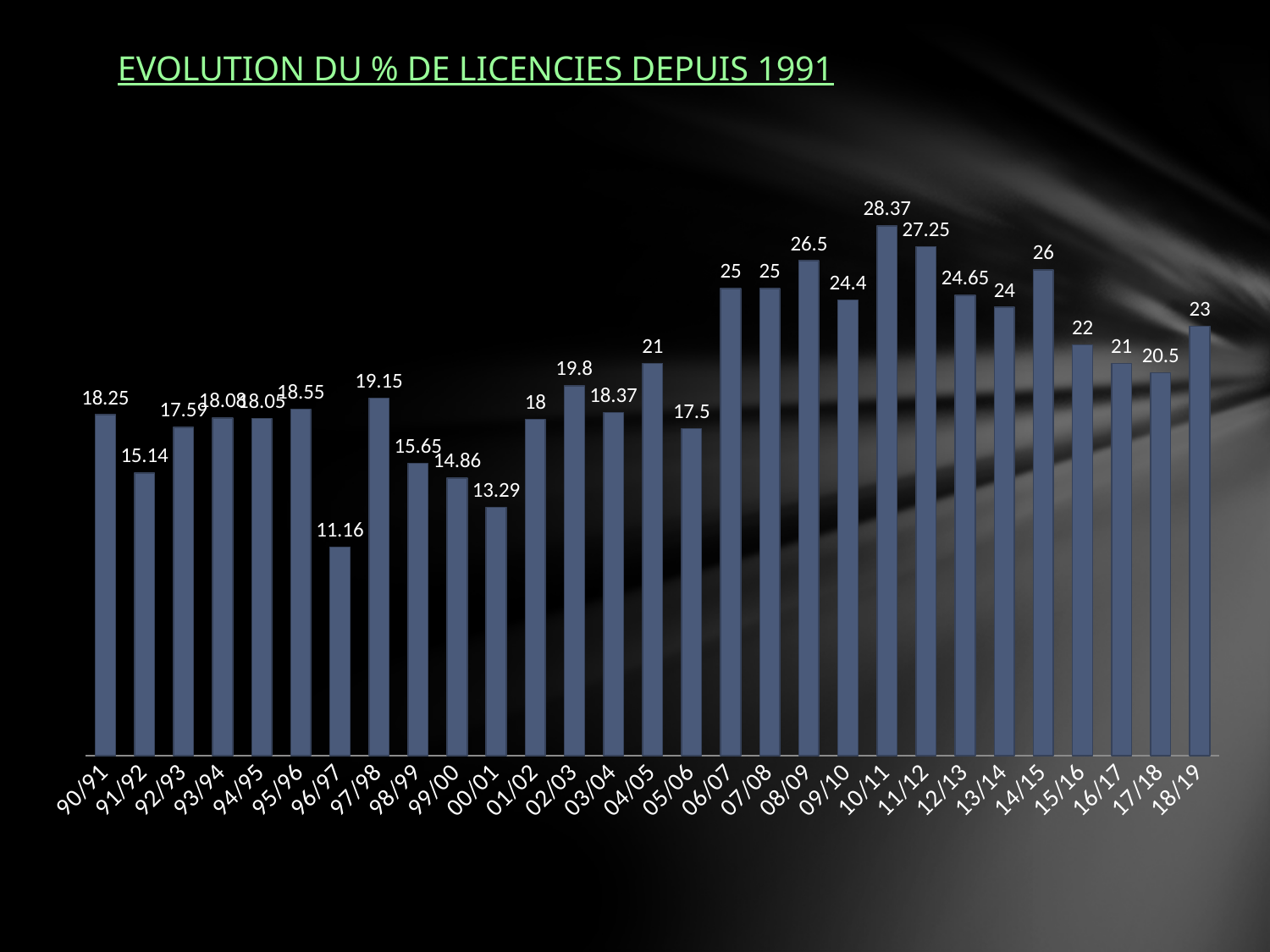
What is the value for 18/19? 23 Which is larger, the value for 14/15 or the value for 15/16? 14/15 What is the difference between the values for 10/11 and 11/12? 1.12 What is the value for 02/03? 19.8 Which season has the highest value? 10/11 What is the difference between the values for 08/09 and 09/10? 2.1 How many seasons are shown on the x axis? 29 What is the value for 10/11? 28.37 Which season has the lowest value? 96/97 What is the title of the chart? EVOLUTION DU % DE LICENCIES DEPUIS 1991 What kind of chart is shown on the slide? Bar chart What is the value for 96/97? 11.16